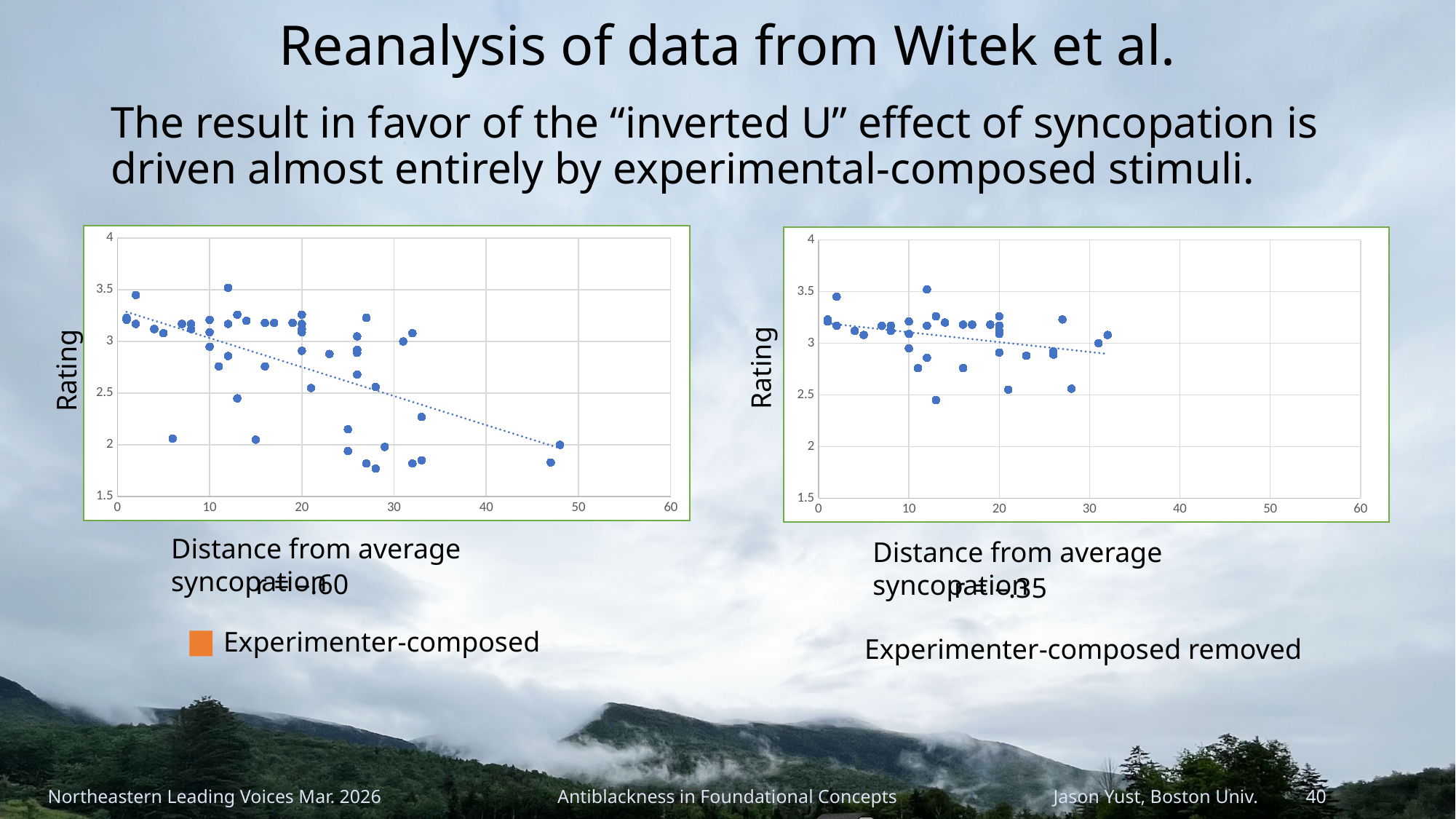
What caption appears below the right chart? Experimenter-composed removed What kind of chart is the right chart (Experimenter-composed removed)? scatter chart What is the label on the vertical axis of the left chart? Rating In the left chart, do the ratings rise or fall as distance from average syncopation increases along the x axis? fall In the left chart, is the rating of the highest point (near 12 on the x axis) greater or less than 3? greater How many charts are shown on the slide? 2 In the right chart (Experimenter-composed removed), is the rating of the rightmost point (near 32 on the x axis) greater or less than 2.5? greater What kind of chart is the left chart on the slide? scatter chart In the left chart, is the rating of the rightmost point (near 48 on the x axis) greater or less than 2.5? less Which chart has the steeper downward trend line, the left chart or the right chart? the left chart In the right chart (Experimenter-composed removed), does the dotted trend line rise or fall along the x axis? fall